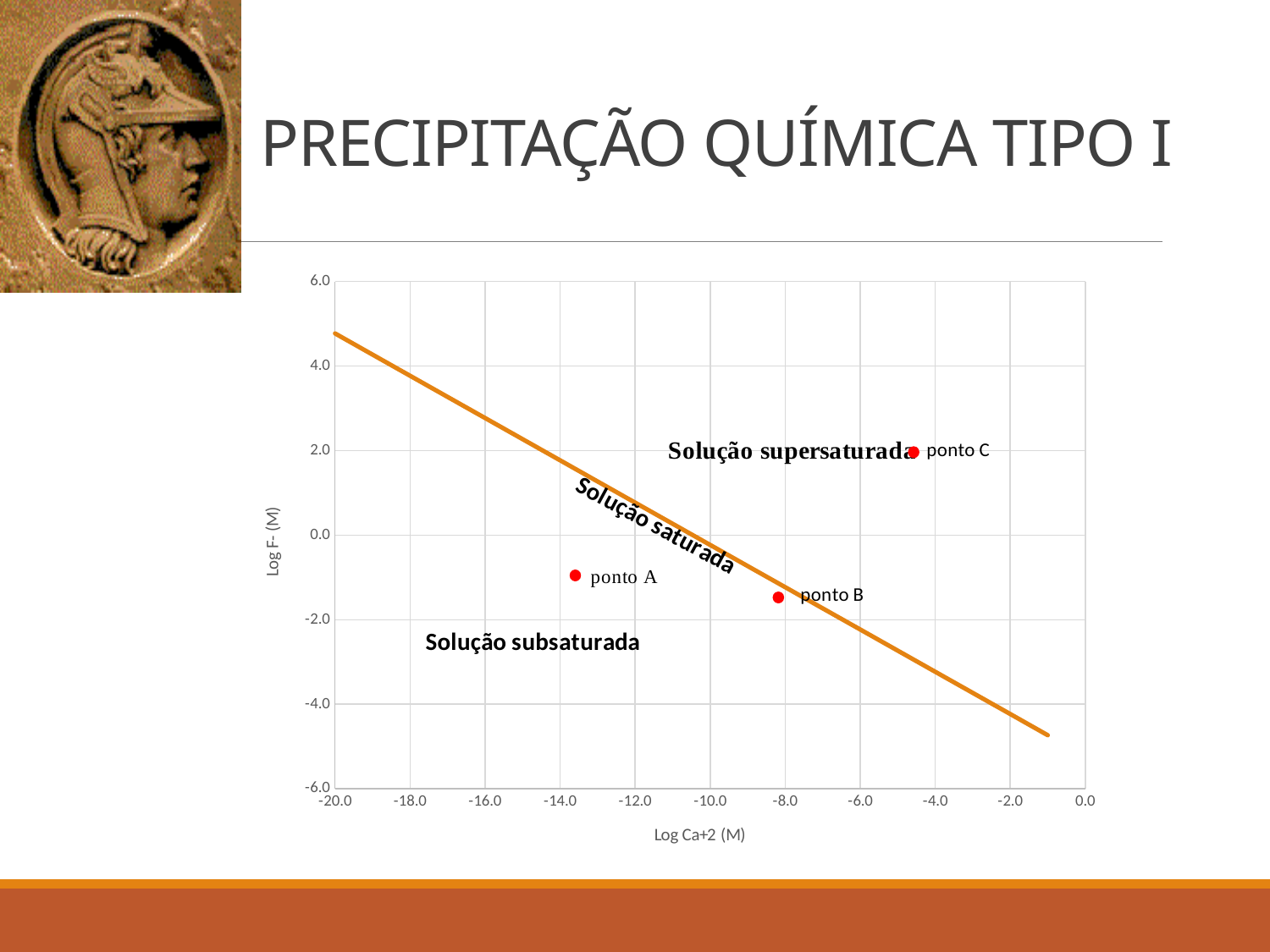
Which has a higher Log F- value, ponto A or ponto B? ponto A What kind of chart is shown on the slide? scatter chart with a line Does the orange line rise or fall as Log Ca+2 increases along the x axis? fall Is the Log F- value for ponto C greater or less than 0.0? greater Which labelled point has the highest Log F- value? ponto C How many labelled points (pontos) are plotted on the chart? 3 Is the Log Ca+2 value for ponto C greater or less than -6.0? greater What is the title of the x axis of the chart? Log Ca+2 (M) Is the Log Ca+2 value for ponto B greater or less than -10.0? greater Which labelled point has the lowest Log Ca+2 value? ponto A